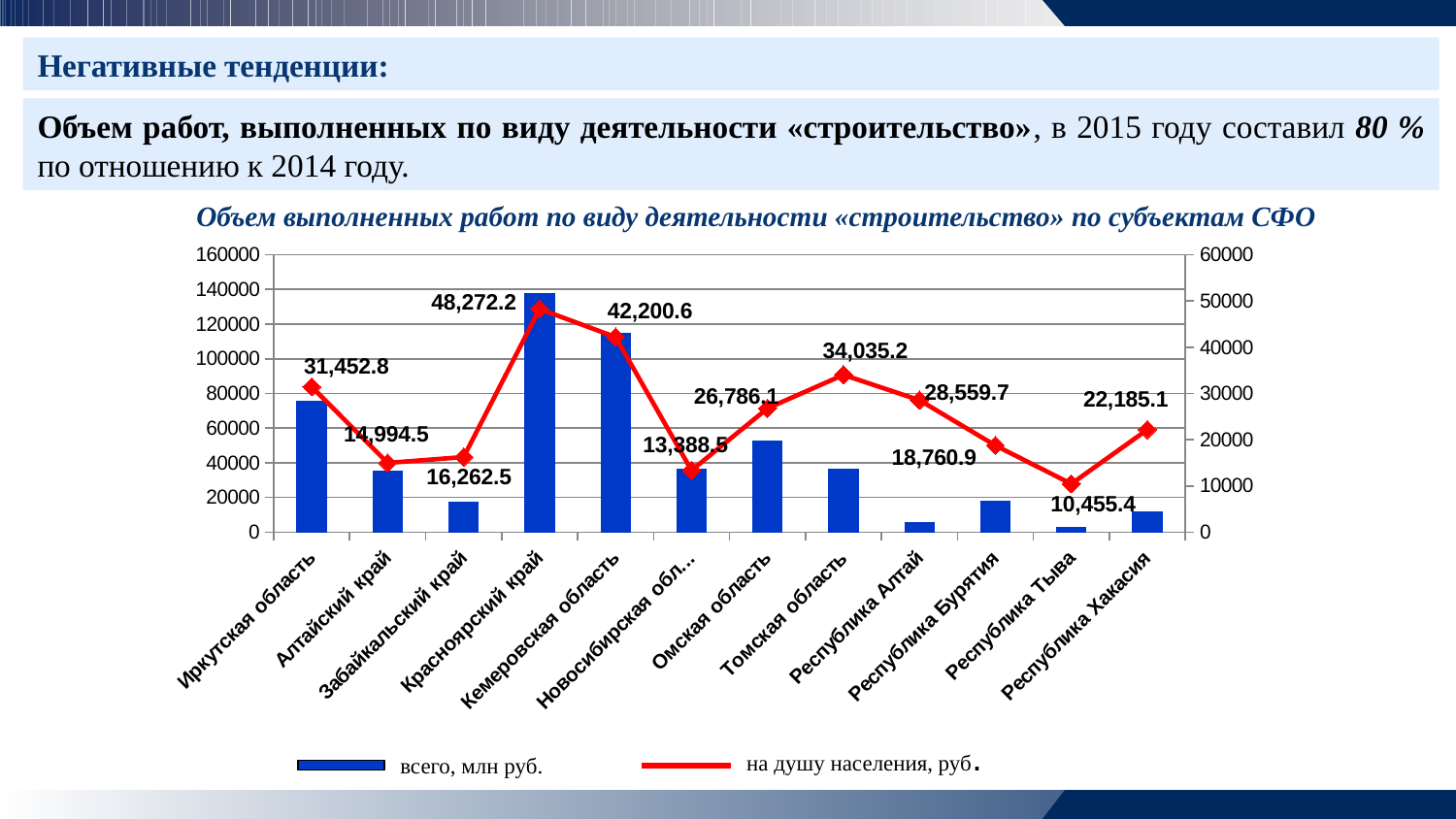
Is the total value (всего, млн руб.) bar for Республика Тыва greater or less than 20000? less How many regions are shown on the x axis of the chart? 12 What is the per capita value (на душу населения, руб.) for Красноярский край? 48,272.2 How many series does the legend list? 2 What is the per capita value (на душу населения, руб.) for Республика Тыва? 10,455.4 What kind of chart is shown on the slide? Combination bar and line chart What is the difference between the per capita values of Красноярский край and Кемеровская область? 6,071.6 What is the per capita value (на душу населения, руб.) for Иркутская область? 31,452.8 Which region has the lowest per capita value (на душу населения, руб.)? Республика Тыва Is the total value (всего, млн руб.) bar for Красноярский край greater or less than 120000? greater Which region has the highest per capita value (на душу населения, руб.)? Красноярский край Which has the larger per capita value, Томская область or Омская область? Томская область